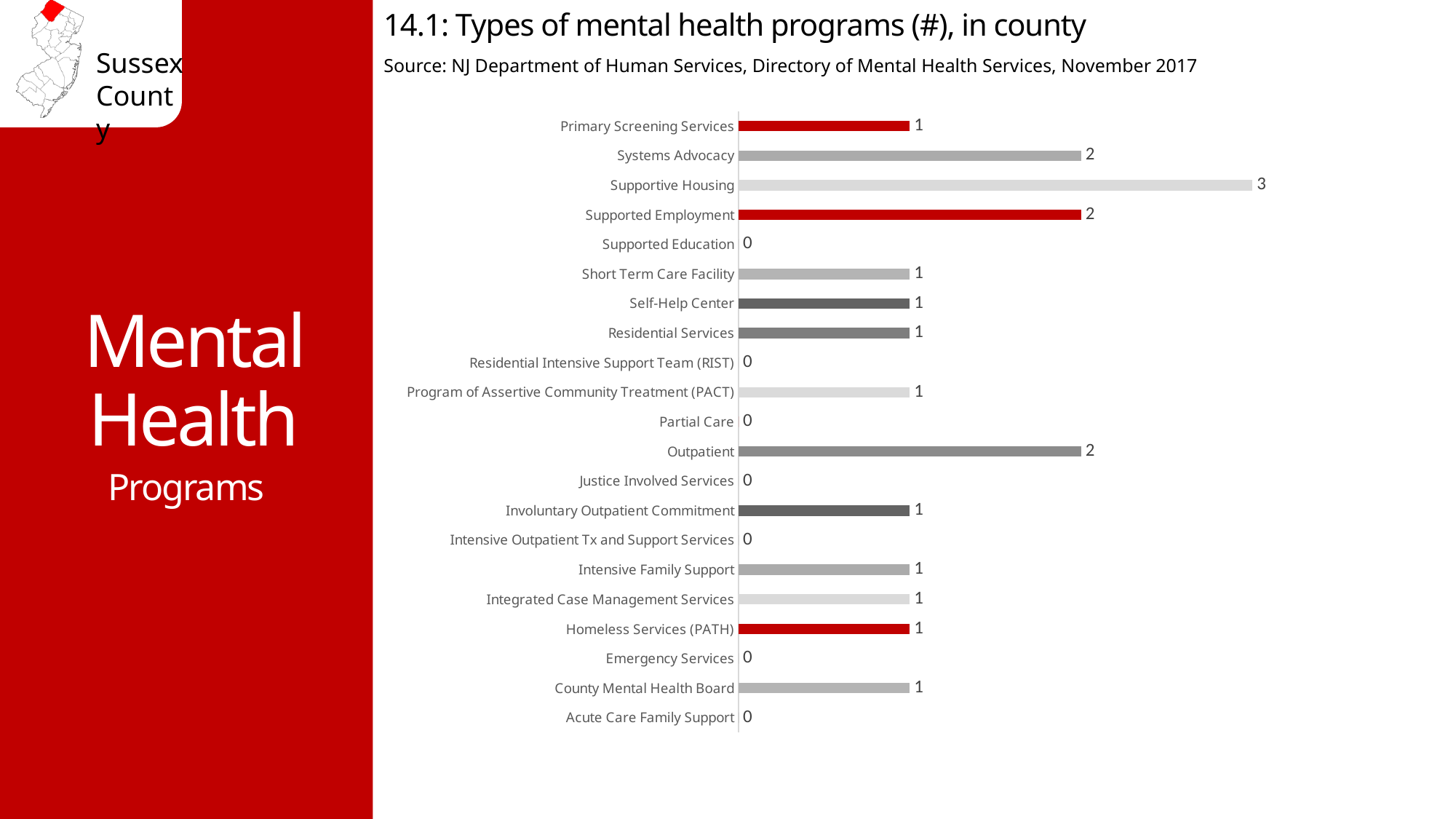
What is the title of the chart? 14.1: Types of mental health programs (#), in county What is the difference between the values for Supportive Housing and Systems Advocacy? 1 How many program types have a value of 2? 3 What is the value for Outpatient? 2 What is the value for Homeless Services (PATH)? 1 Which is larger, the value for Supported Employment or the value for Self-Help Center? Supported Employment What is the value for Supportive Housing? 3 How many program types (categories) are listed in the chart? 21 What is the value for Supported Education? 0 How many program types have a value of 0? 7 What type of chart is shown on the slide? bar chart Which program type has the highest number of programs? Supportive Housing